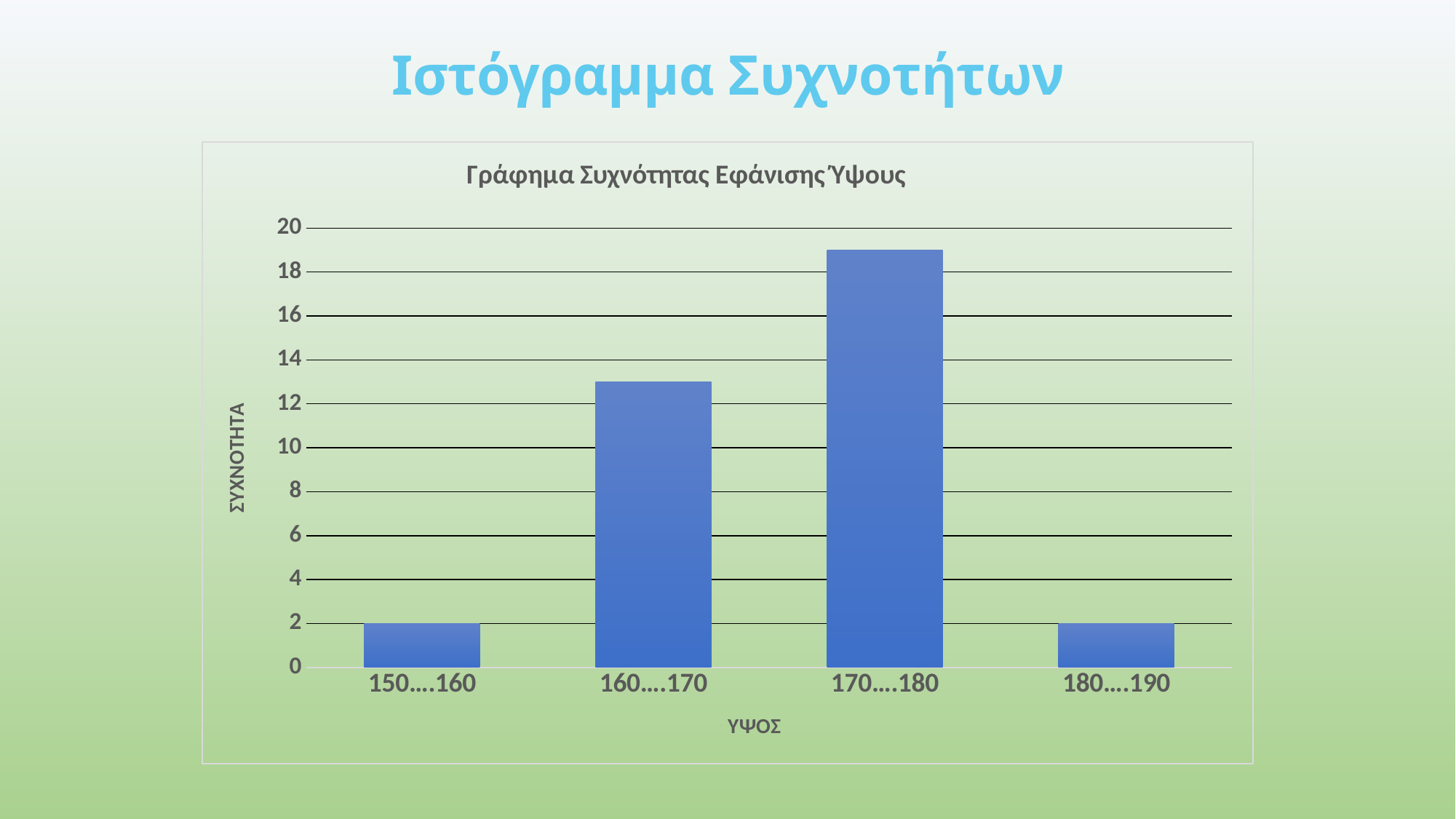
Which is larger, the value for 150....160 or the value for 160....170? 160....170 What is the value for the 150....160 category? 2 How many categories are shown on the x axis? 4 What is the label of the vertical axis? ΣΥΧΝΟΤΗΤΑ Is the value for 170....180 greater or less than 20? less Is the value for 170....180 greater or less than 16? greater Which category has the highest value? 170....180 Which is larger, the value for 160....170 or the value for 170....180? 170....180 What is the value for the 180....190 category? 2 Is the value for 160....170 greater or less than 10? greater What kind of chart is shown on the slide? bar chart What is the title of the chart? Γράφημα Συχνότητας Εφάνισης Ύψους